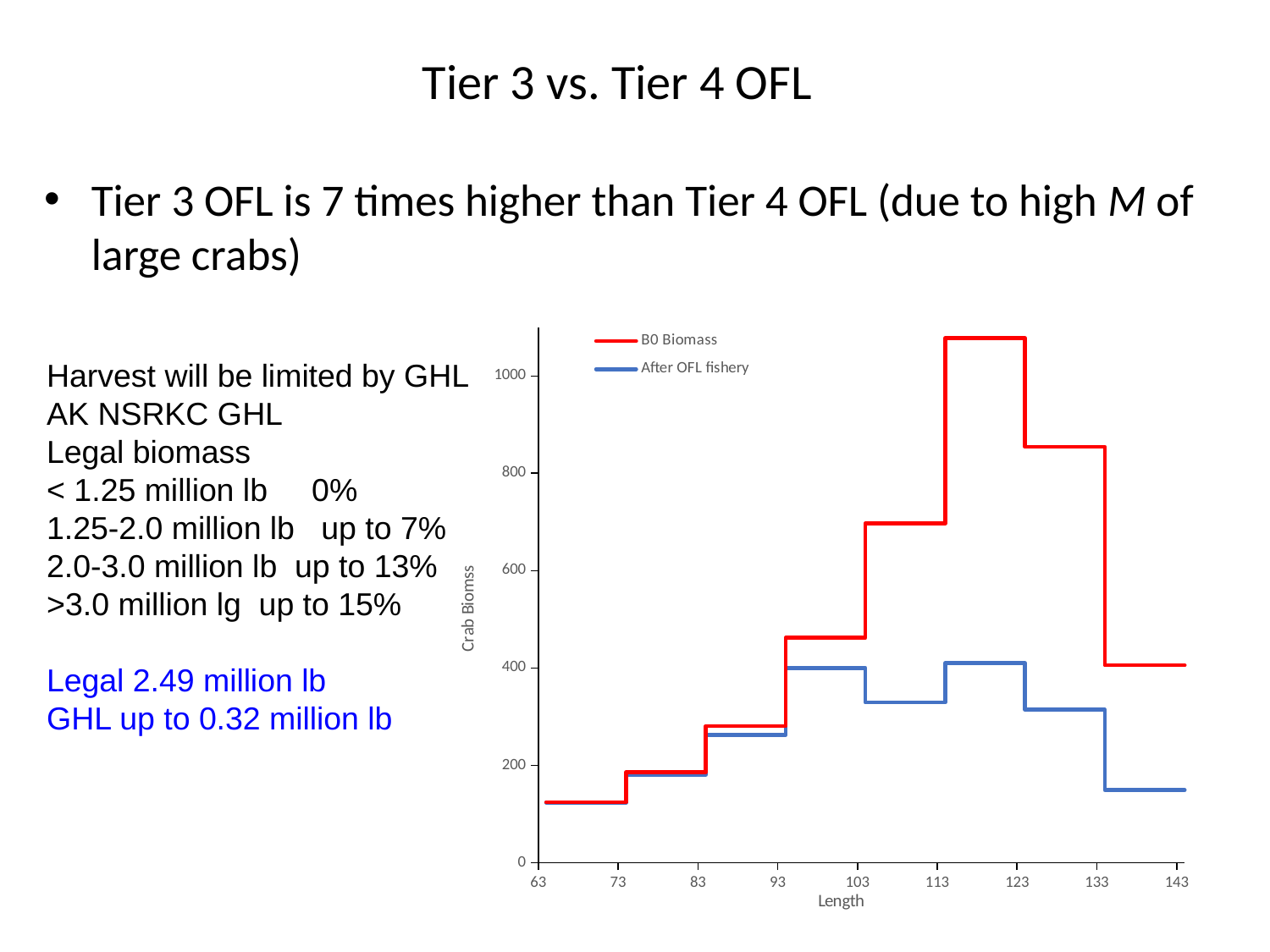
Is the After OFL fishery value at length 108 greater or less than 400? less Is the After OFL fishery value at length 138 greater or less than 200? less Is the B0 Biomass value at length 118 greater or less than 1000? greater At length 118, which series has the higher value, B0 Biomass or After OFL fishery? B0 Biomass How many series does the chart legend list? 2 What are the two series named in the chart legend? B0 Biomass and After OFL fishery Does the B0 Biomass series rise or fall between length 63 and length 118? rise What kind of chart is shown on the slide? line chart What is the label of the x axis of the chart? Length